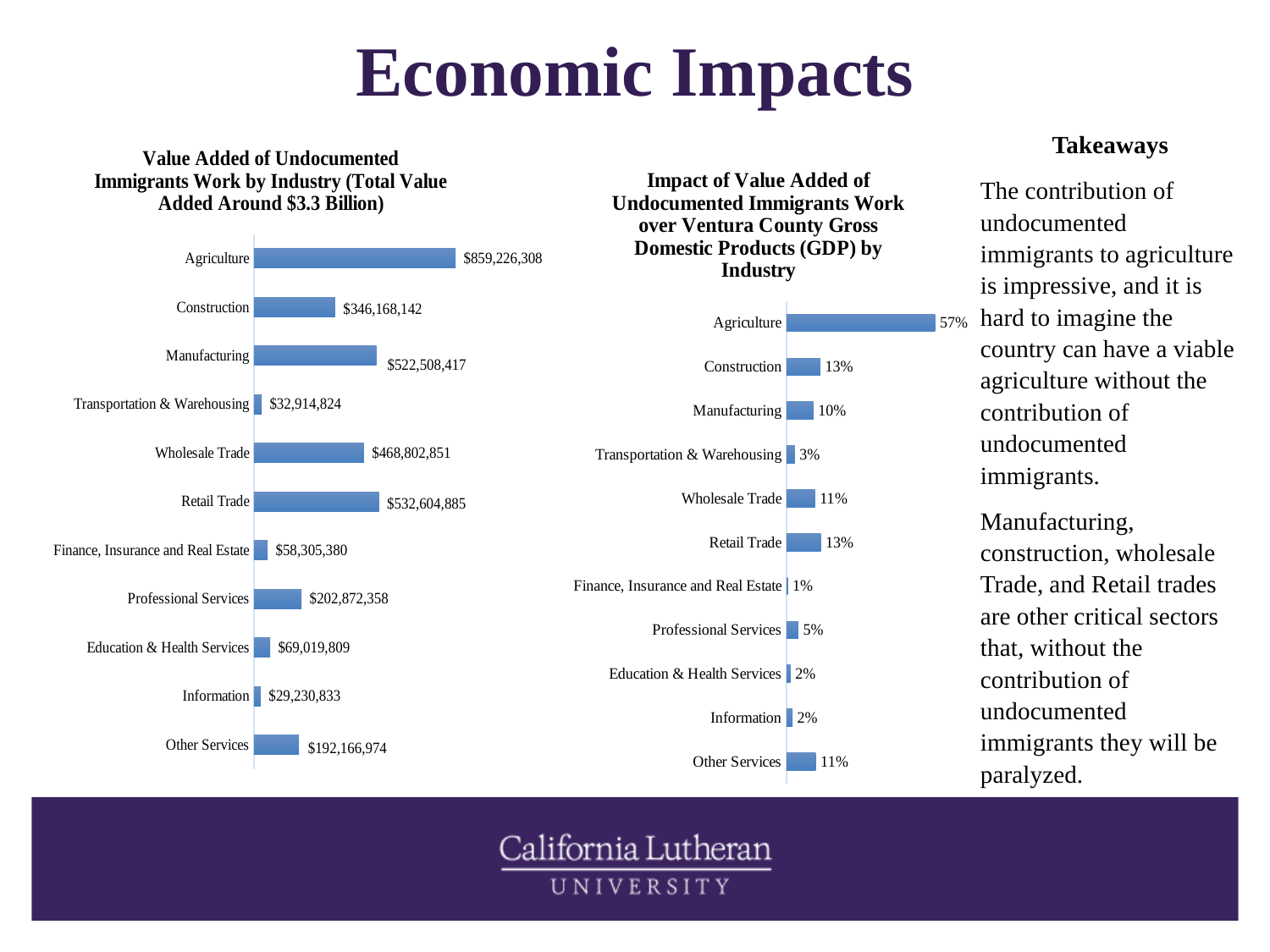
In the left chart (Value Added of Undocumented Immigrants Work by Industry), which industry has the lowest value added? Information What type of chart is the left chart (Value Added of Undocumented Immigrants Work by Industry)? Bar chart In the right chart (Impact of Value Added over Ventura County GDP by Industry), what is the difference in percentage points between Agriculture and Retail Trade? 44 percentage points In the left chart (Value Added of Undocumented Immigrants Work by Industry), what is the value for Agriculture? $859,226,308 In the left chart (Value Added of Undocumented Immigrants Work by Industry), what is the value for Retail Trade? $532,604,885 In the right chart (Impact of Value Added over Ventura County GDP by Industry), which industry has the lowest percentage? Finance, Insurance and Real Estate In the right chart (Impact of Value Added over Ventura County GDP by Industry), what is the percentage for Agriculture? 57% In the left chart (Value Added of Undocumented Immigrants Work by Industry), which industry has the highest value added? Agriculture How many industries are shown in the right chart (Impact of Value Added over Ventura County GDP by Industry)? 11 In the left chart (Value Added of Undocumented Immigrants Work by Industry), what is the difference between the values for Agriculture and Construction? $513,058,166 In the left chart (Value Added of Undocumented Immigrants Work by Industry), which is larger: Manufacturing or Wholesale Trade? Manufacturing In the right chart (Impact of Value Added over Ventura County GDP by Industry), what is the percentage for Professional Services? 5%